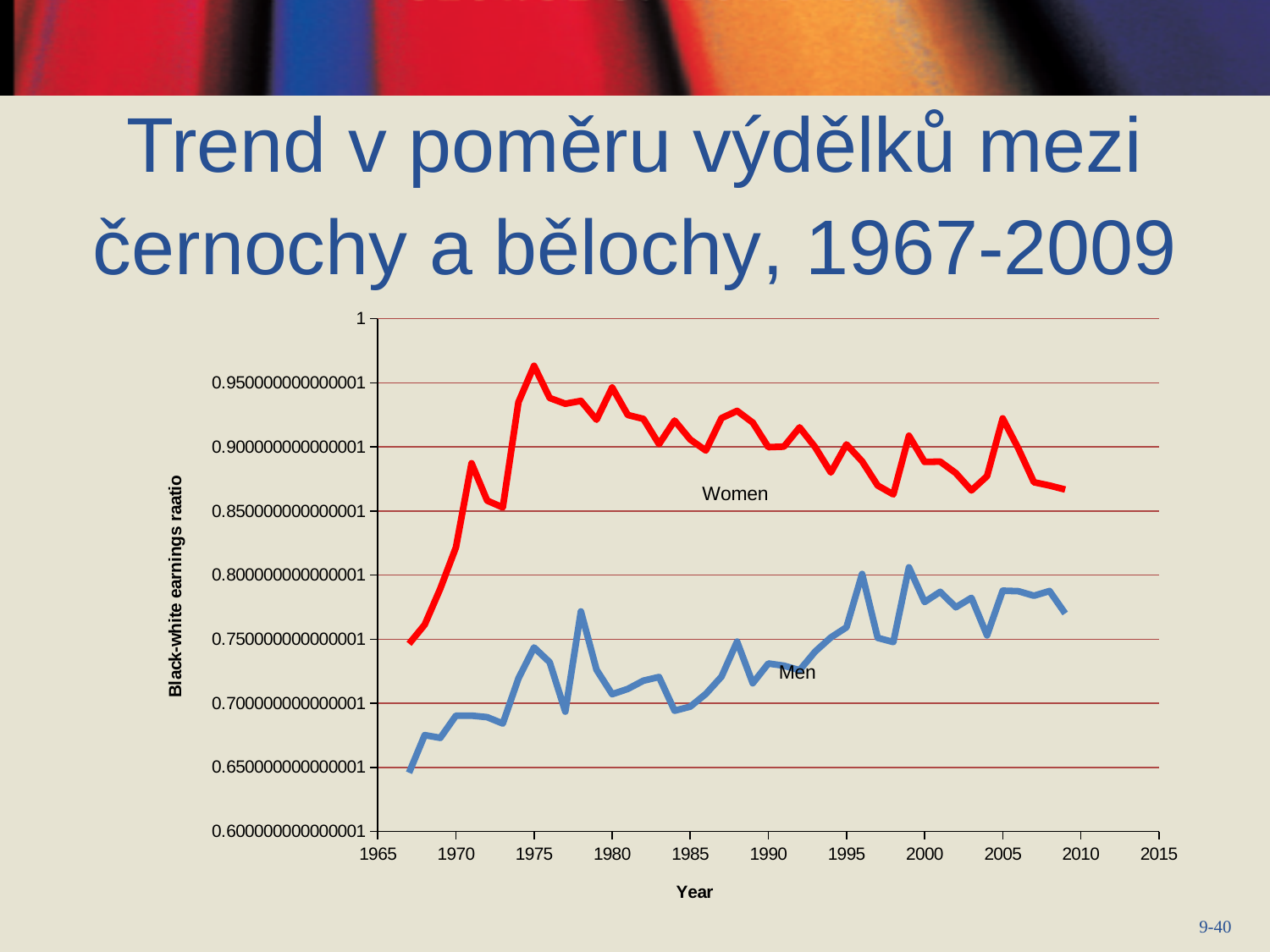
Is the value for Men in 1996 greater or less than 0.75? greater What is the label of the x axis? Year Which two series are labelled on the chart? Women and Men Is the value for Men in 1970 greater or less than 0.7? less Does the Women series generally rise or fall from 1975 to 2009? fall Is the value for Women in 1975 greater or less than 0.95? greater What kind of chart is shown on the slide? line chart Does the Men series generally rise or fall from 1967 to 2009? rise How many series are plotted on the chart? 2 Which series has the higher value in 1990, Women or Men? Women